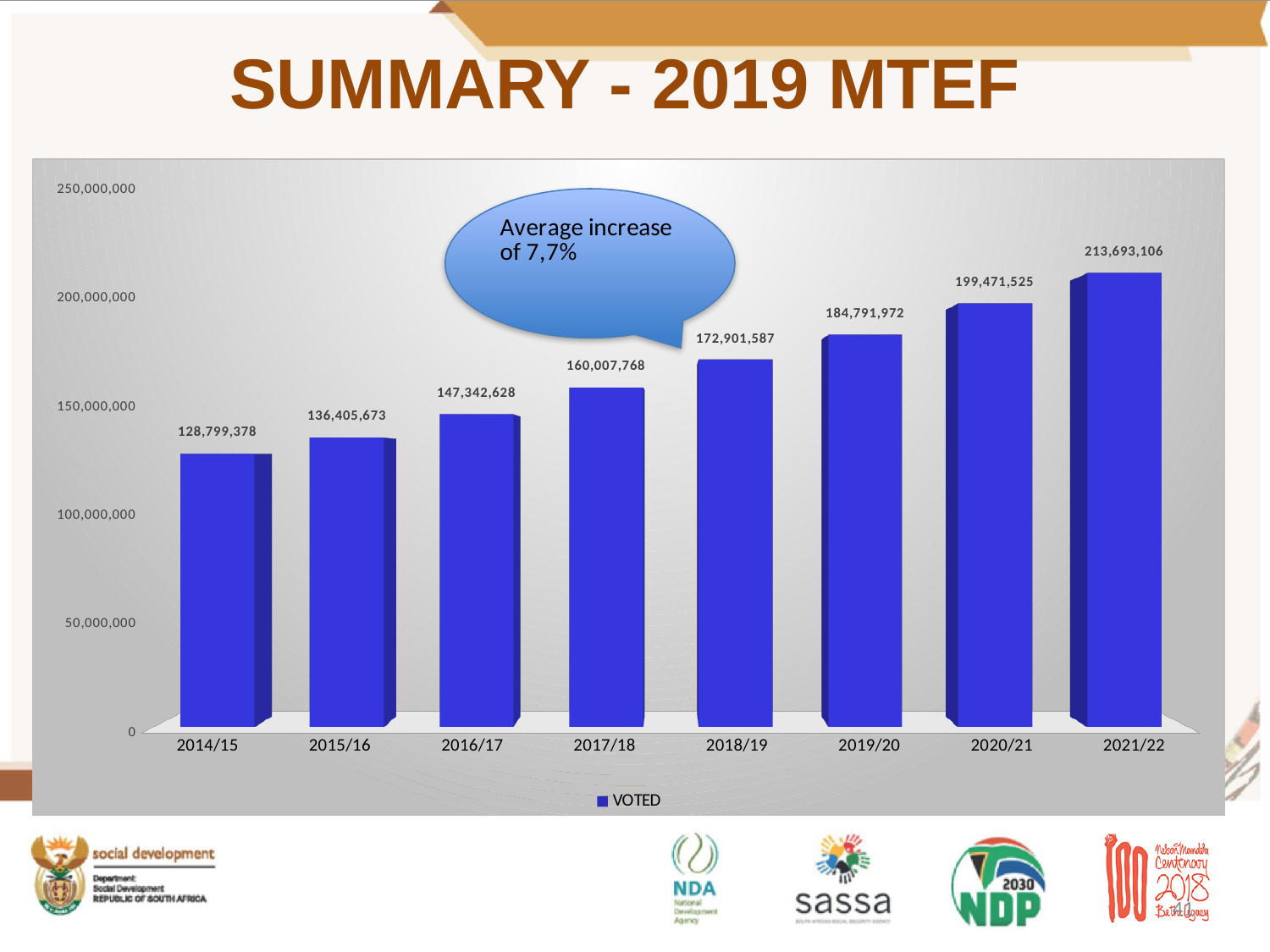
How many series does the legend list? 1 What is the difference between the VOTED values for 2020/21 and 2019/20? 14,679,553 What kind of chart is shown on the slide? bar chart Which year has the lowest VOTED value? 2014/15 How many years are shown on the x axis of the chart? 8 What is the difference between the VOTED values for 2021/22 and 2014/15? 84,893,728 What is the VOTED value for 2020/21? 199,471,525 What is the VOTED value for 2017/18? 160,007,768 Do the VOTED values rise or fall from 2014/15 to 2021/22? rise Is the VOTED value for 2019/20 greater or less than 200,000,000? less Which year has the highest VOTED value? 2021/22 Which is larger, the VOTED value for 2018/19 or for 2016/17? 2018/19